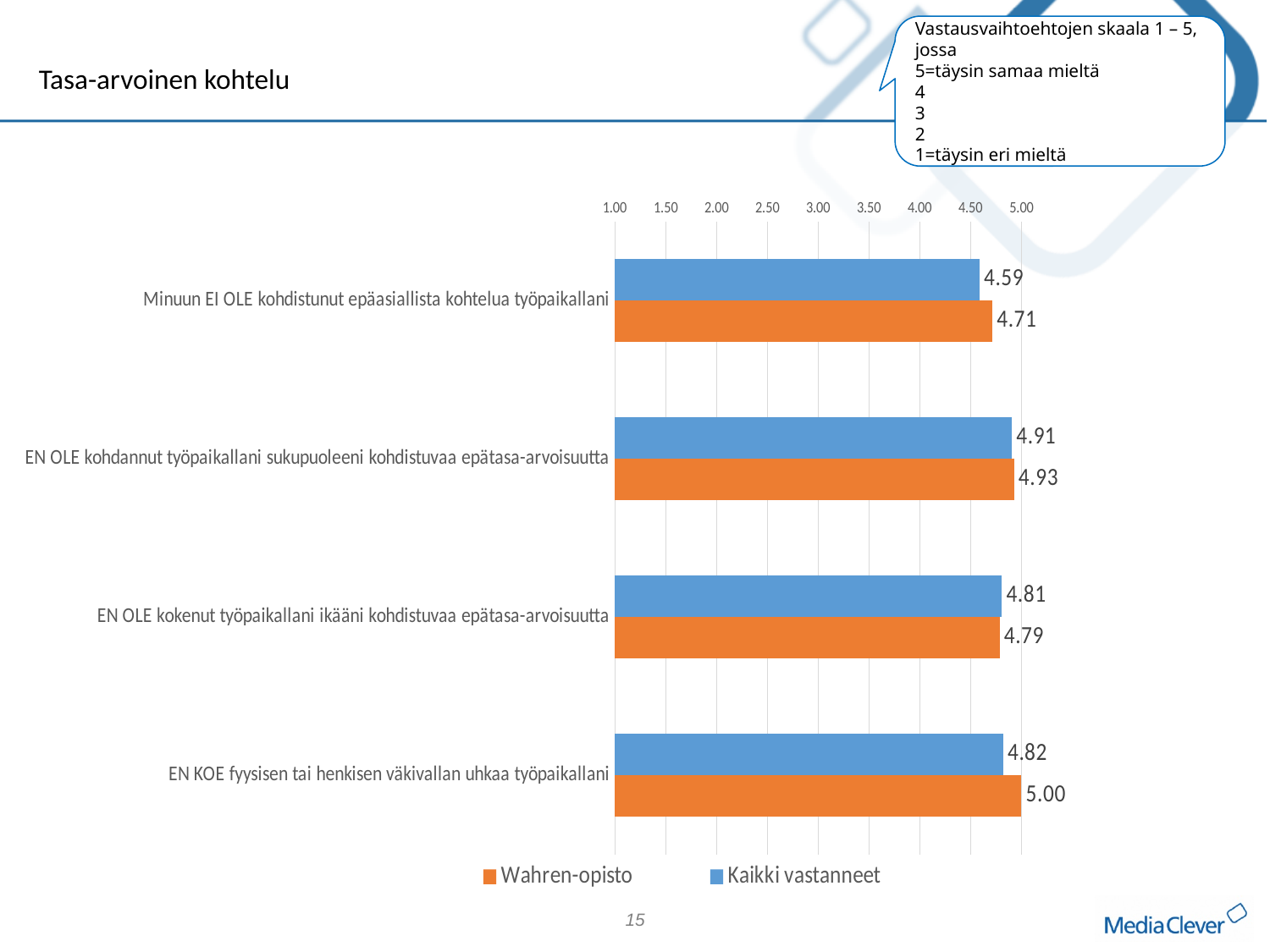
How many categories are shown in the chart? 4 What is the value for Kaikki vastanneet on "EN OLE kohdannut työpaikallani sukupuoleeni kohdistuvaa epätasa-arvoisuutta"? 4.91 What is the value for Wahren-opisto on "EN KOE fyysisen tai henkisen väkivallan uhkaa työpaikallani"? 5.00 Which category has the lowest value for Kaikki vastanneet? Minuun EI OLE kohdistunut epäasiallista kohtelua työpaikallani What is the value for Kaikki vastanneet on "Minuun EI OLE kohdistunut epäasiallista kohtelua työpaikallani"? 4.59 How many series does the legend list? 2 On "EN OLE kokenut työpaikallani ikääni kohdistuvaa epätasa-arvoisuutta", which series has the larger value, Wahren-opisto or Kaikki vastanneet? Kaikki vastanneet What is the difference between the Wahren-opisto and Kaikki vastanneet values on "Minuun EI OLE kohdistunut epäasiallista kohtelua työpaikallani"? 0.12 What kind of chart is shown on the slide? Bar chart Which category has the highest value for Wahren-opisto? EN KOE fyysisen tai henkisen väkivallan uhkaa työpaikallani What is the value for Wahren-opisto on "EN OLE kokenut työpaikallani ikääni kohdistuvaa epätasa-arvoisuutta"? 4.79 What is the difference between the Wahren-opisto and Kaikki vastanneet values on "EN KOE fyysisen tai henkisen väkivallan uhkaa työpaikallani"? 0.18